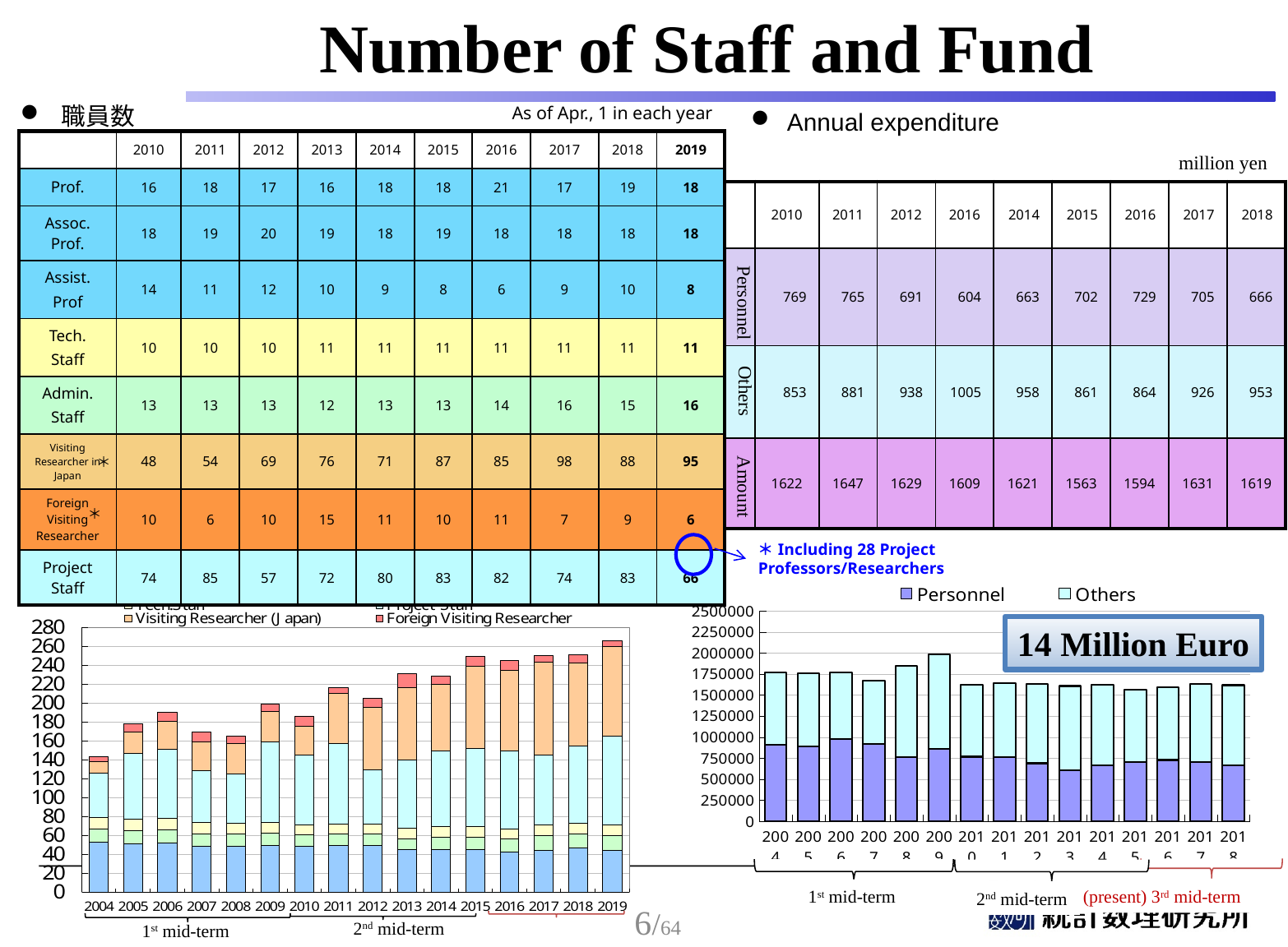
What kind of chart is the chart at the bottom right of the slide? Stacked bar chart What kind of chart is the chart at the bottom left of the slide? Stacked bar chart In the bottom-right chart, is the Personnel value for 2006 larger or smaller than the Personnel value for 2013? larger In the bottom-right chart, is the total bar height for 2009 greater or less than 1750000? greater How many years are shown on the x axis of the bottom-left chart? 16 In the bottom-left chart, is the total bar height for 2004 greater or less than 160? less In the bottom-left chart, which year has the tallest stacked bar? 2019 In the bottom-left chart, which year has the shortest stacked bar? 2004 In the bottom-right chart, what are the two legend entries? Personnel and Others In the bottom-right chart, how many series does the legend list? 2 How many years are shown on the x axis of the bottom-right chart? 15 In the bottom-right chart, which year has the tallest stacked bar? 2009